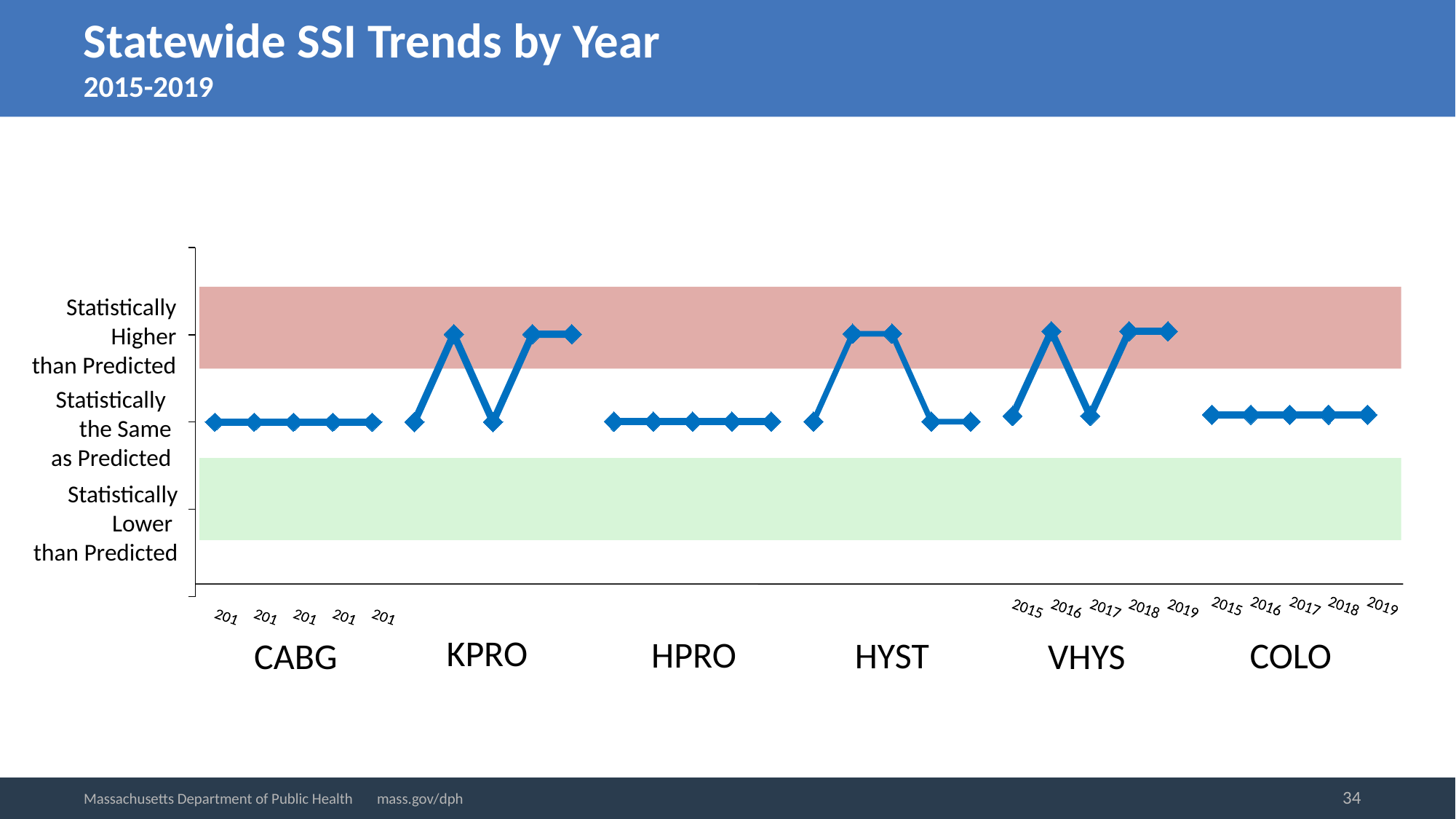
Which procedure groups have all five points in the Statistically the Same as Predicted band? CABG, HPRO, COLO In which band does the COLO point for 2019 fall? Statistically the Same as Predicted How many procedure groups have at least one point in the Statistically Higher than Predicted band? 3 How many data points are plotted for each procedure group? 5 How many procedure groups are plotted along the x axis? 6 What kind of chart is shown on the slide? line chart Does the VHYS line change band between 2018 and 2019? No In which band does the VHYS point for 2018 fall? Statistically Higher than Predicted In which band does the VHYS point for 2017 fall? Statistically the Same as Predicted In which band does the VHYS point for 2016 fall? Statistically Higher than Predicted